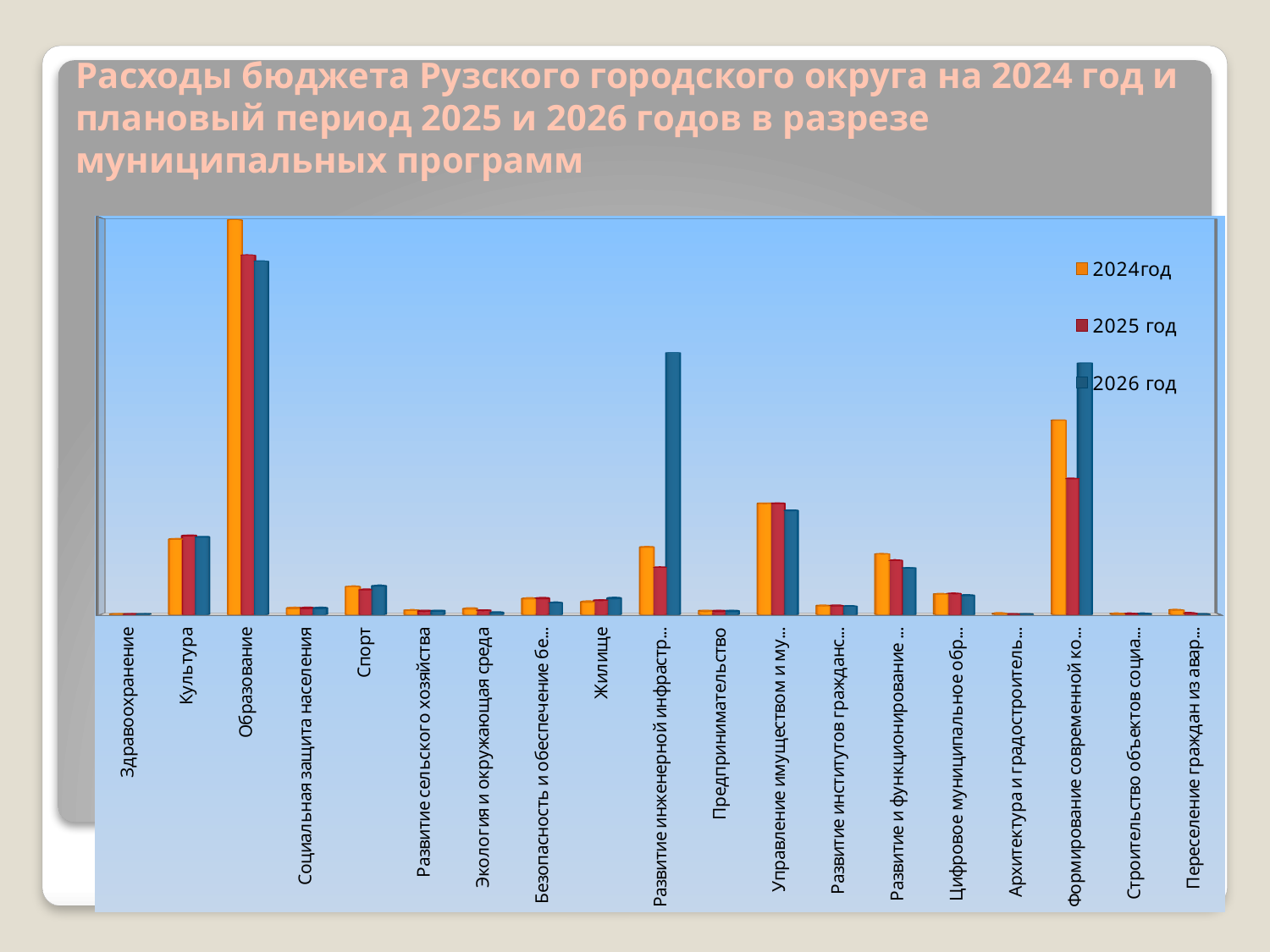
For Образование, do the values rise or fall from 2024год to 2026 год? fall Which category has the highest value for the 2024год series? Образование For Формирование современной ко..., which is larger: the 2024год value or the 2025 год value? 2024год For the 2024год series, which is larger: Управление имуществом и му... or Формирование современной ко...? Формирование современной ко... For Развитие инженерной инфрастр..., which series has the larger value: 2024год or 2026 год? 2026 год How many categories (municipal programmes) are shown on the x axis? 19 Which series is shown in orange? 2024год How many series does the legend list? 3 Which category has the highest value for the 2026 год series? Образование Which colour represents the 2025 год series in the legend? red What kind of chart is shown on the slide? bar chart